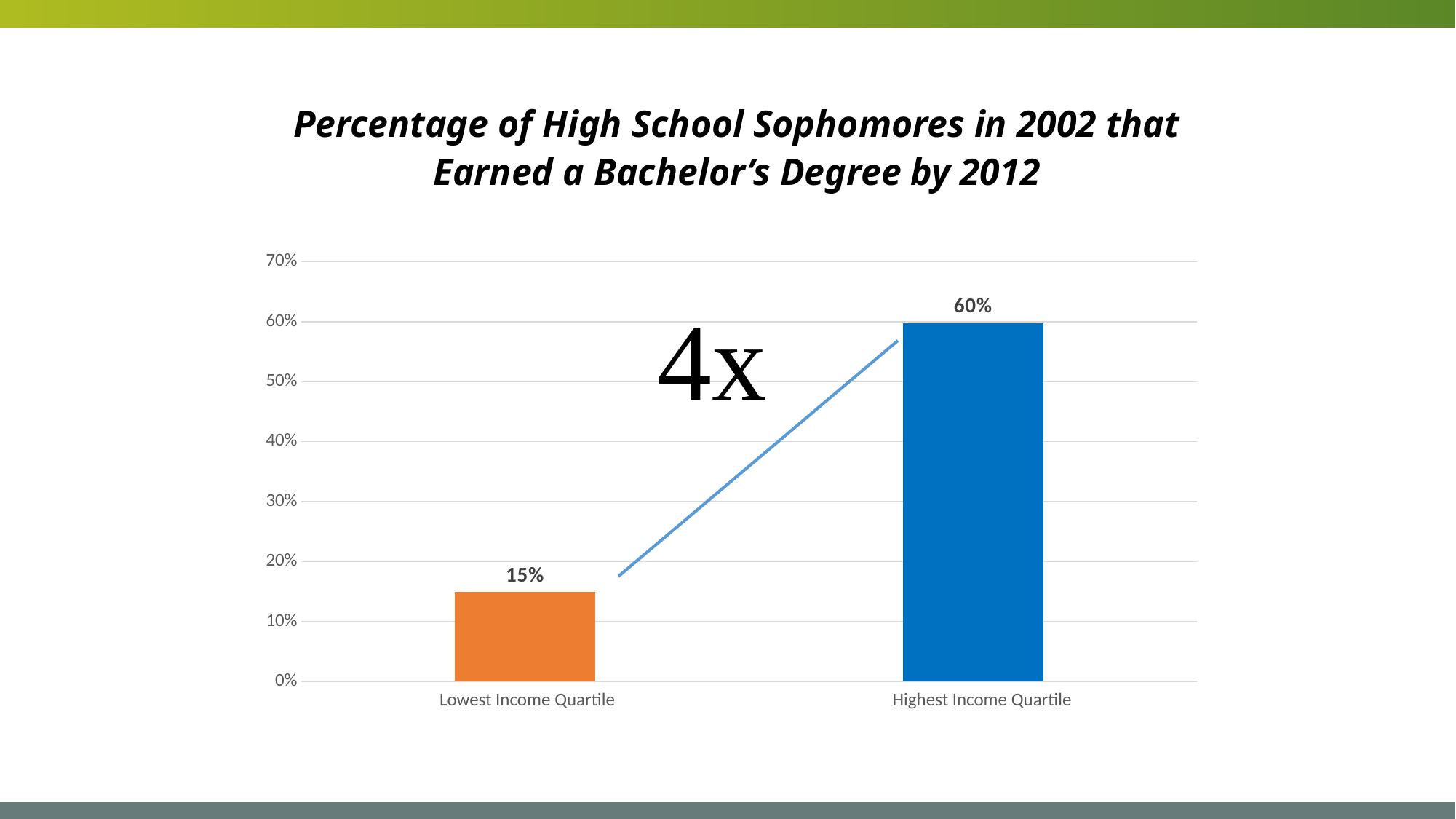
What multiplier is annotated between the two bars on the chart? 4x What kind of chart is shown on the slide? Bar chart What is the title of the chart? Percentage of High School Sophomores in 2002 that Earned a Bachelor's Degree by 2012 Which is larger, the value for Lowest Income Quartile or Highest Income Quartile? Highest Income Quartile What is the value for Highest Income Quartile? 60% Which category has the lowest value? Lowest Income Quartile Is the value for Highest Income Quartile greater or less than 50%? greater How many categories are shown on the chart? 2 Which category has the highest value? Highest Income Quartile What is the value for Lowest Income Quartile? 15% What is the difference between the values for Highest Income Quartile and Lowest Income Quartile? 45% Is the value for Lowest Income Quartile greater or less than 20%? less